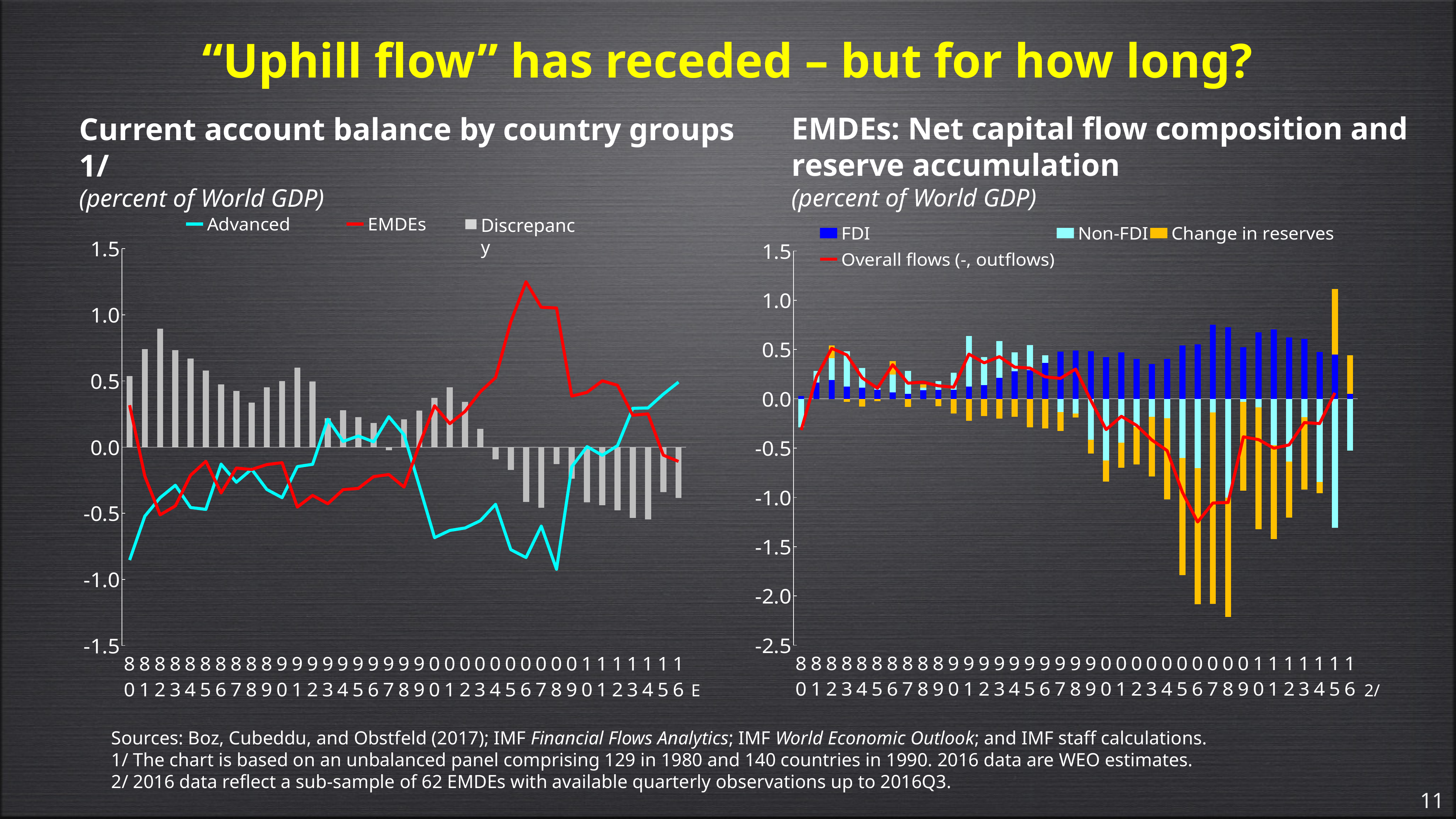
On the left chart, does the EMDEs line rise or fall between 2006 and 2016? fall On the right chart (EMDEs: Net capital flow composition and reserve accumulation), how many series does the legend list? 4 On the right chart, is the FDI value in 2007 greater or less than 0.5? greater On the left chart (Current account balance by country groups), how many series does the legend list? 3 On the left chart, in which year does the EMDEs line reach its highest value? 2006 On the left chart, is the Advanced value in 1980 greater or less than -0.5? less On the right chart, what colour represents Change in reserves in the legend? orange On the right chart, in which year does the Overall flows line reach its lowest value? 2006 On the left chart, is the EMDEs value in 2006 greater or less than 1.0? greater On the right chart, is the Overall flows (-, outflows) series drawn as bars or as a line? line On the left chart, is the Discrepancy series drawn as bars or as a line? bars